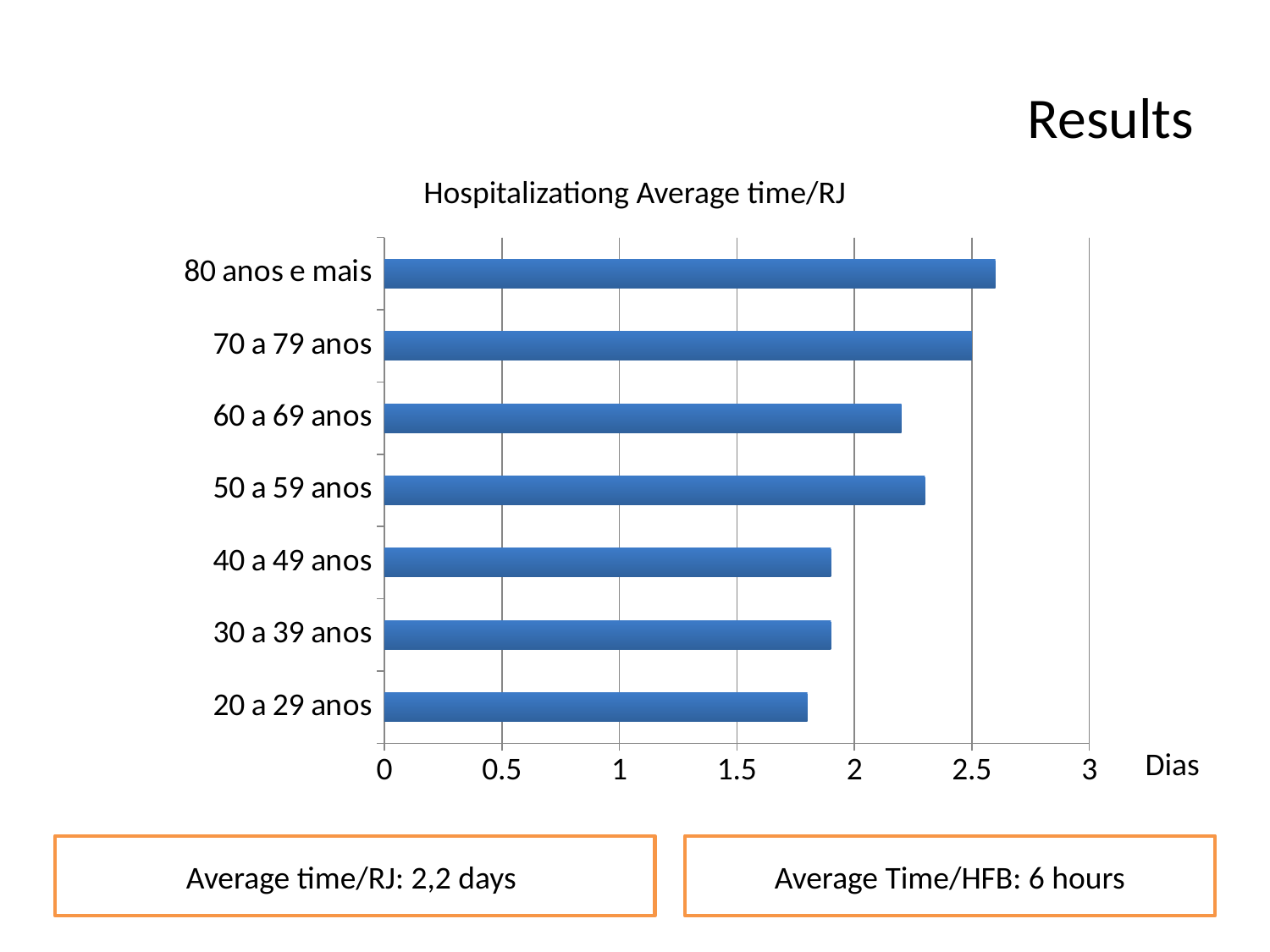
Is the value for 20 a 29 anos greater or less than 2? less What is the title of the chart? Hospitalizationg Average time/RJ What is the value for 70 a 79 anos? 2.5 Is the value for 80 anos e mais greater or less than 2.5? greater Is the value for 60 a 69 anos greater or less than 2? greater What type of chart is shown on the slide? bar chart Which is larger, the value for 50 a 59 anos or the value for 60 a 69 anos? 50 a 59 anos How many age categories are plotted in the chart? 7 What label is shown on the horizontal axis of the chart? Dias Which age category has the highest value? 80 anos e mais Which age category has the lowest value? 20 a 29 anos